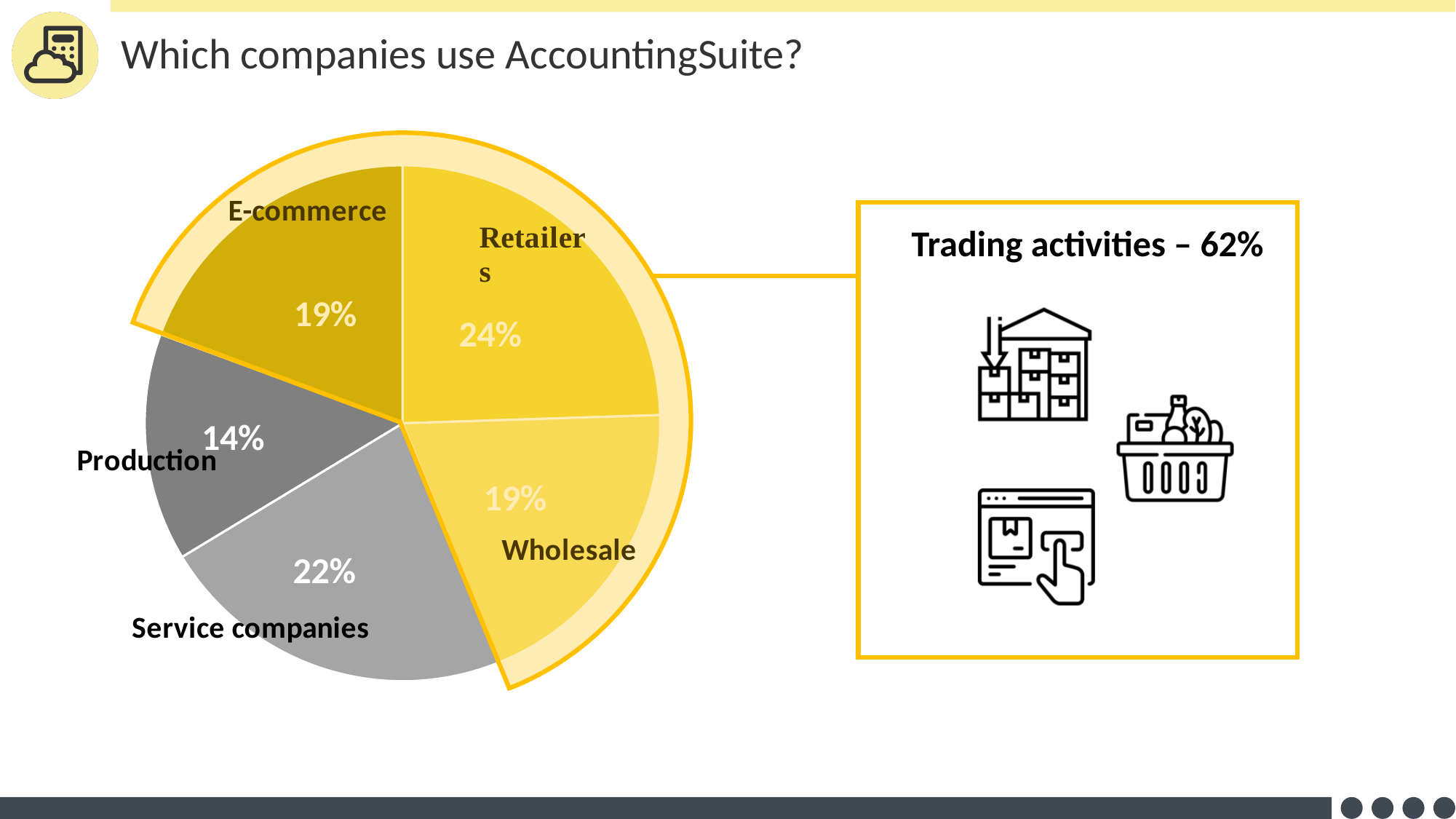
Which is larger, Service companies or E-commerce? Service companies What is the combined share of Retailers, Wholesale and E-commerce? 62% What percentage of the pie is Service companies? 22% What percentage of the pie is Retailers? 24% What percentage does the call-out box give for Trading activities? 62% How many slices does the pie chart have? 5 Which category has the largest slice of the pie? Retailers Which category has the smallest slice of the pie? Production What percentage of the pie is Production? 14% What is the difference in percentage points between Retailers and Production? 10 What percentage of the pie is Wholesale? 19% What kind of chart is shown on the slide? pie chart